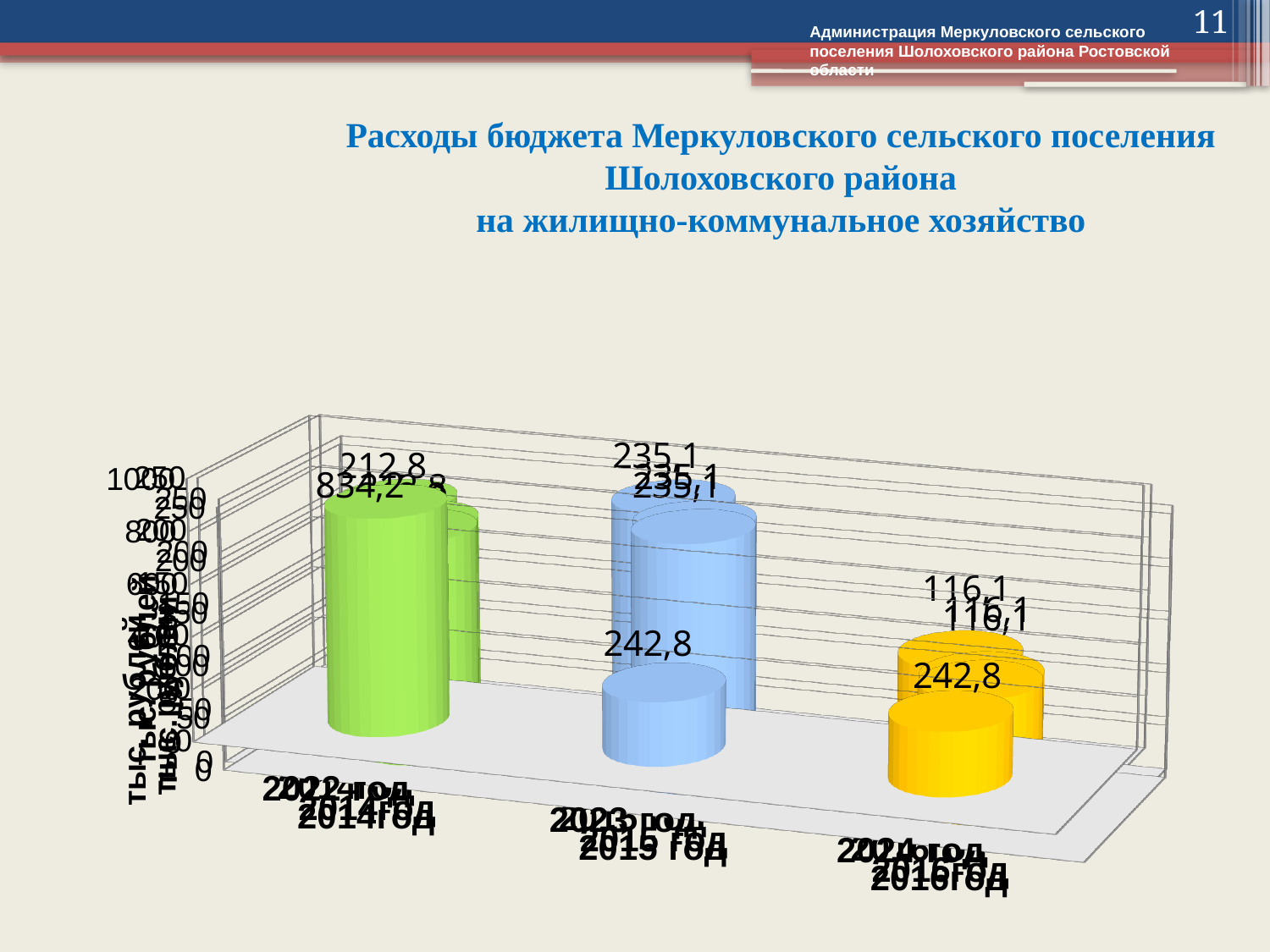
Is the front green bar (834,2) larger or smaller than the front blue bar (242,8)? larger How many categories (groups of bars) are shown along the x axis of the chart? 3 What colour is the first (leftmost) bar in the chart? green What kind of chart is shown on the slide? bar chart What value is printed on the tall green bar at the front of the chart? 834,2 What value is printed on the short yellow bar at the front of the chart? 242,8 What is the difference between the front green bar (834,2) and the front yellow bar (242,8)? 591,4 Which colour bar at the front of the chart is the tallest? green What colour is the third (rightmost) bar in the chart? yellow What value is printed on the short blue bar at the front of the chart? 242,8